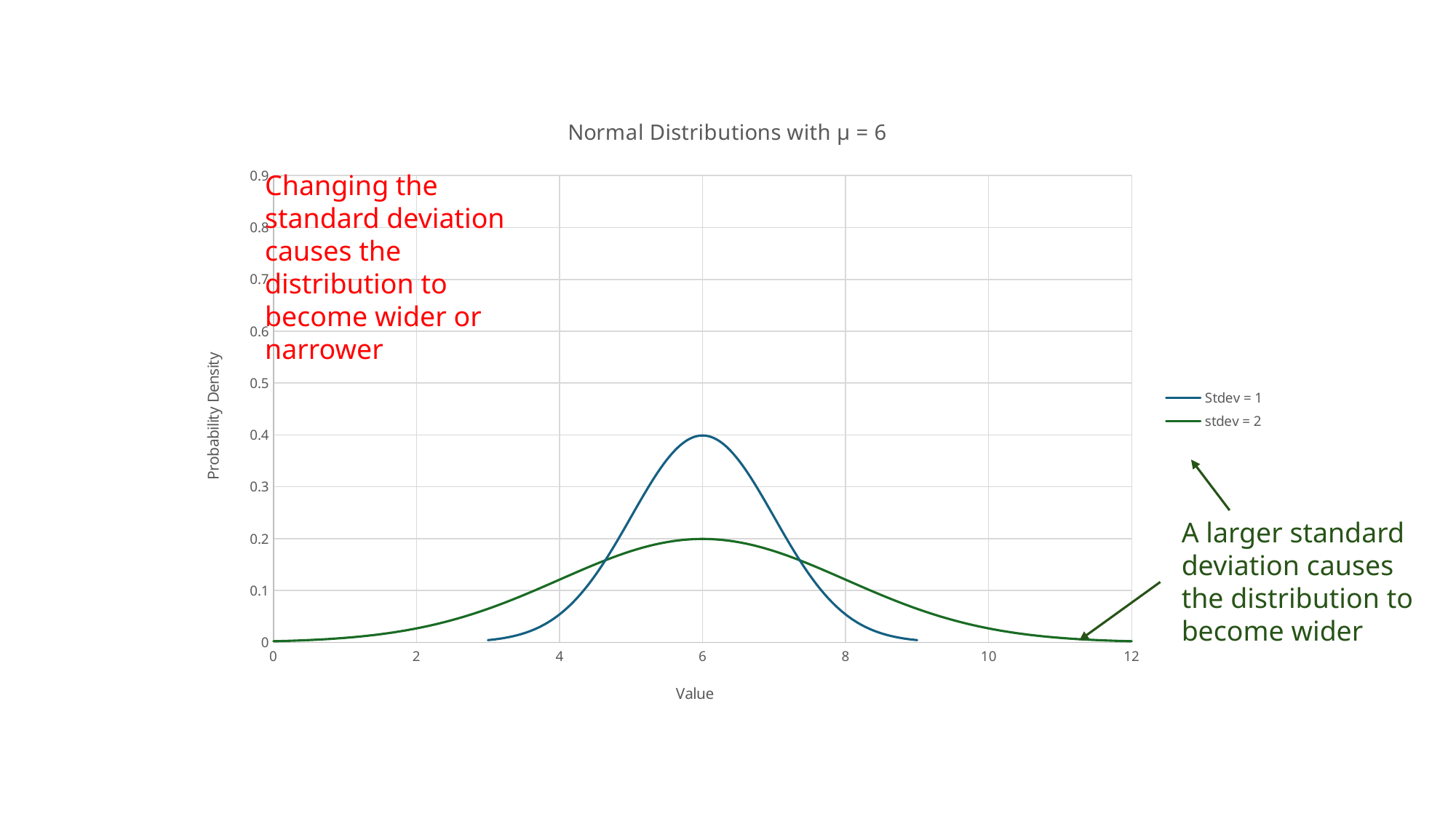
How many series does the legend list? 2 Is the value of the stdev = 2 curve at Value 6 greater or less than 0.3? less What is the label of the vertical axis? Probability Density What is the peak probability density of the Stdev = 1 curve? 0.4 At Value 8, which series has the higher probability density, Stdev = 1 or stdev = 2? stdev = 2 What is the difference between the peak of the Stdev = 1 curve and the peak of the stdev = 2 curve? 0.2 What kind of chart is shown on the slide? line chart Which series reaches the higher peak probability density? Stdev = 1 What is the peak probability density of the stdev = 2 curve? 0.2 At which value on the x axis do both curves reach their peak? 6 What is the title of the chart? Normal Distributions with μ = 6 Does the Stdev = 1 curve rise or fall as Value increases from 6 to 9? fall